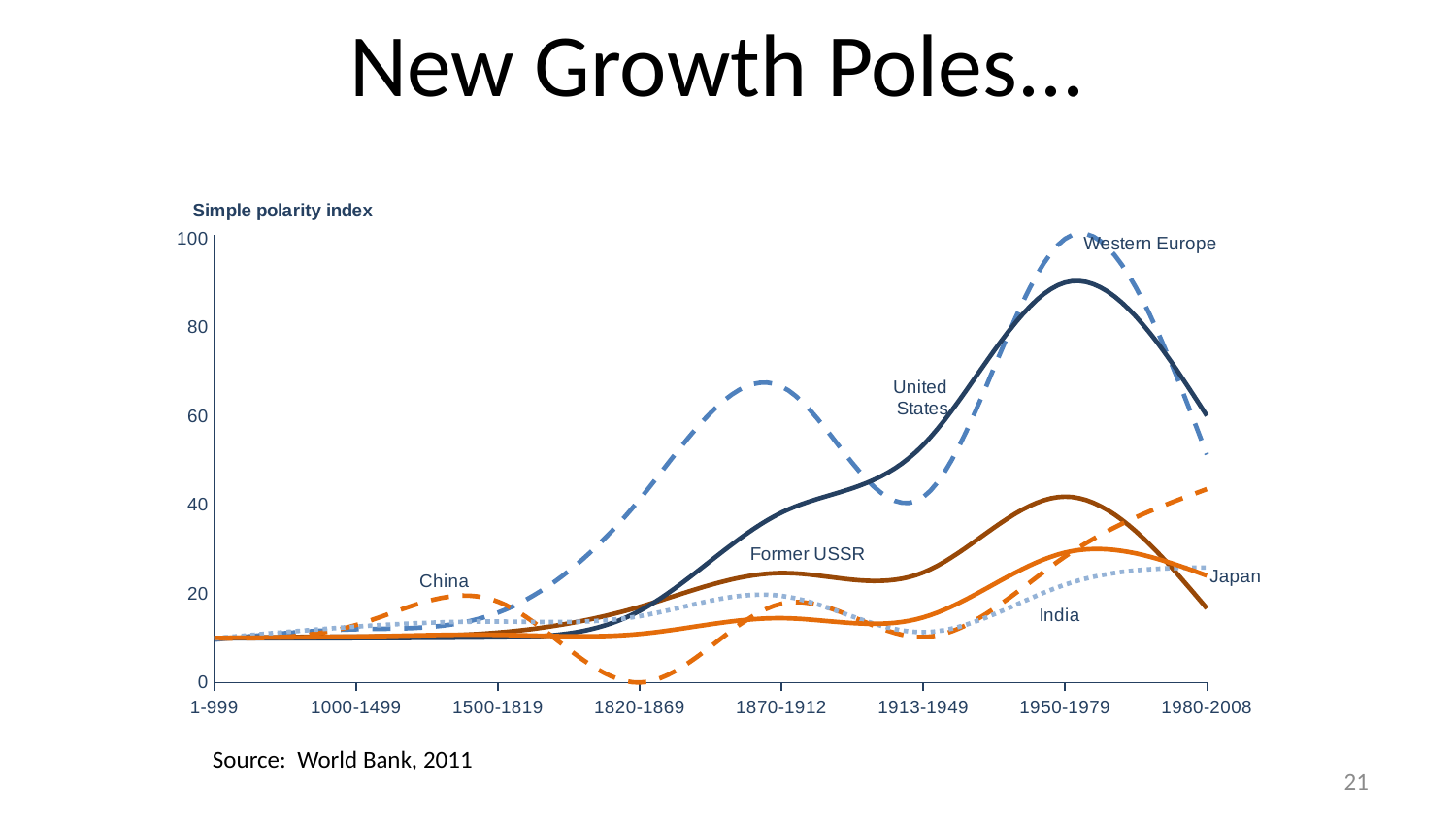
What is the title of the y axis (the index plotted)? Simple polarity index Is the value for Western Europe in 1870-1912 greater or less than 60? greater Is the value for the United States in 1950-1979 greater or less than 80? greater How many time periods are shown along the x axis? 8 How many regions are labeled on the chart? 6 What kind of chart is shown on the slide? Line chart In the 1870-1912 period, which is larger: Western Europe or the United States? Western Europe What source is cited for the chart? World Bank, 2011 Which region has the lowest value in the 1820-1869 period? China Does the Western Europe line rise or fall from 1950-1979 to 1980-2008? fall Is the value for China in 1820-1869 greater or less than 20? less Which region has the highest value in the 1950-1979 period? Western Europe